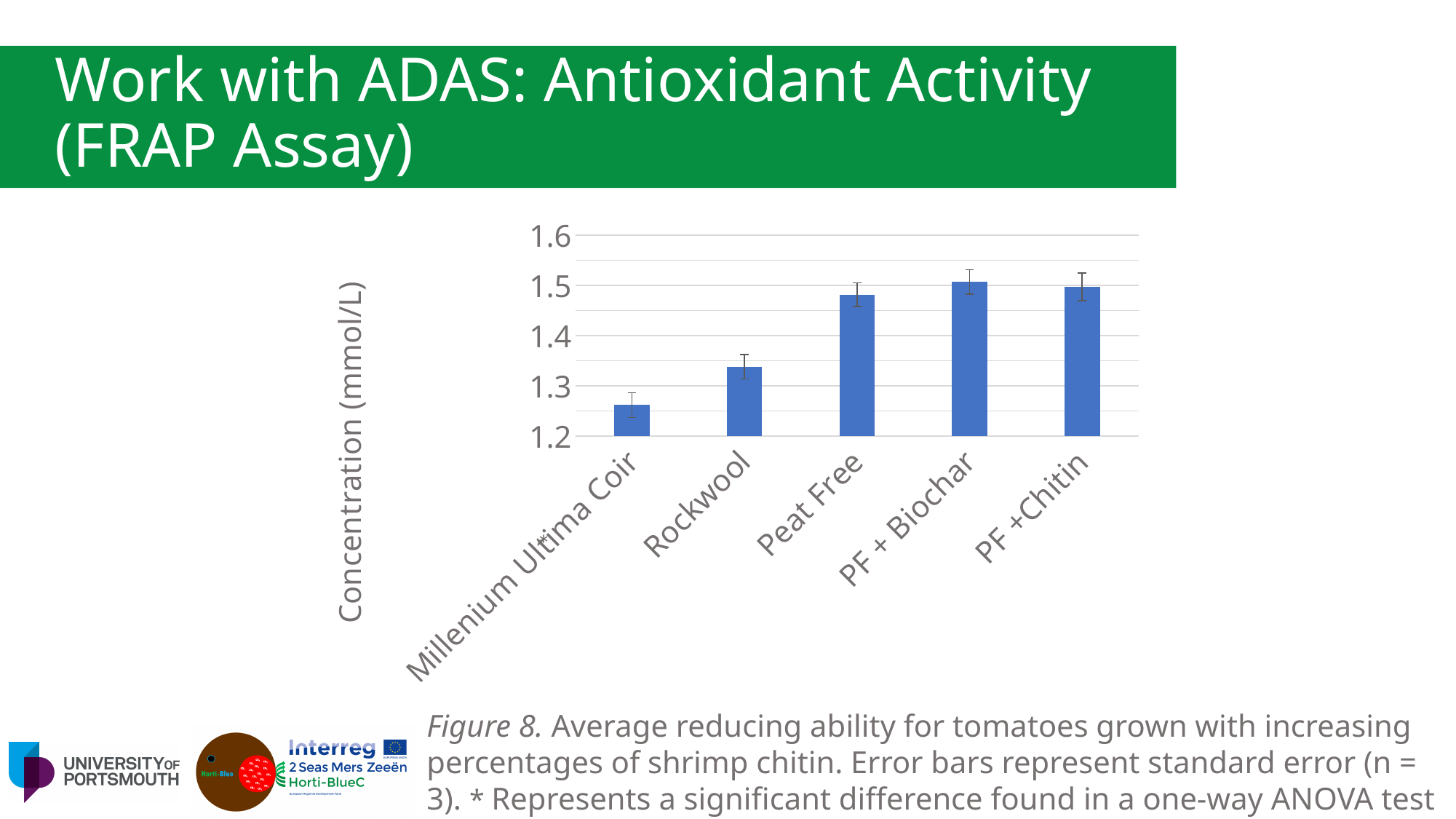
Which has a higher concentration, Peat Free or Rockwool? Peat Free Is the value for Rockwool greater or less than 1.4? less What is the label on the vertical axis of the chart? Concentration (mmol/L) How many growing media categories are plotted on the chart? 5 Is the value for Millenium Ultima Coir greater or less than 1.3? less Is the value for Peat Free greater or less than 1.5? less What kind of chart is shown on the slide? Bar chart Which has a higher concentration, Rockwool or Millenium Ultima Coir? Rockwool What do the error bars on the chart represent, according to the figure caption? Standard error (n = 3) Which category has the lowest concentration? Millenium Ultima Coir